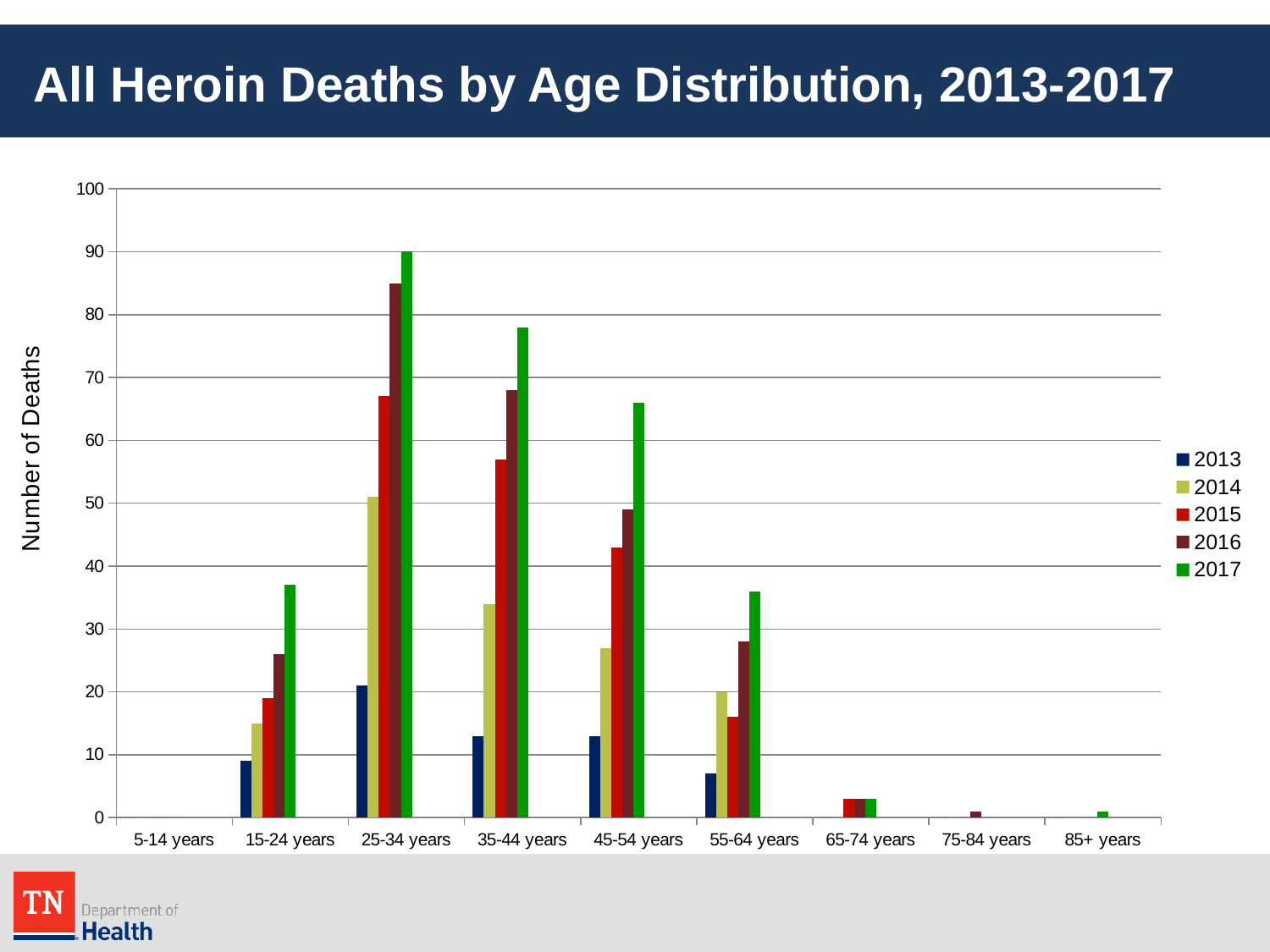
How many series does the legend list? 5 Which year has the lowest number of deaths in the 15-24 years age group? 2013 Is the value for 2016 in the 55-64 years age group greater or less than 30? less What type of chart is shown on the slide? bar chart In the 45-54 years age group, which is larger: the value for 2015 or the value for 2016? 2016 Is the value for 2017 in the 45-54 years age group greater or less than 60? greater Is the value for 2016 in the 25-34 years age group greater or less than 80? greater Which year has the highest number of deaths in the 35-44 years age group? 2017 What is the title of the vertical axis? Number of Deaths How many age groups are shown on the x axis? 9 Which age group has the highest number of heroin deaths in 2017? 25-34 years